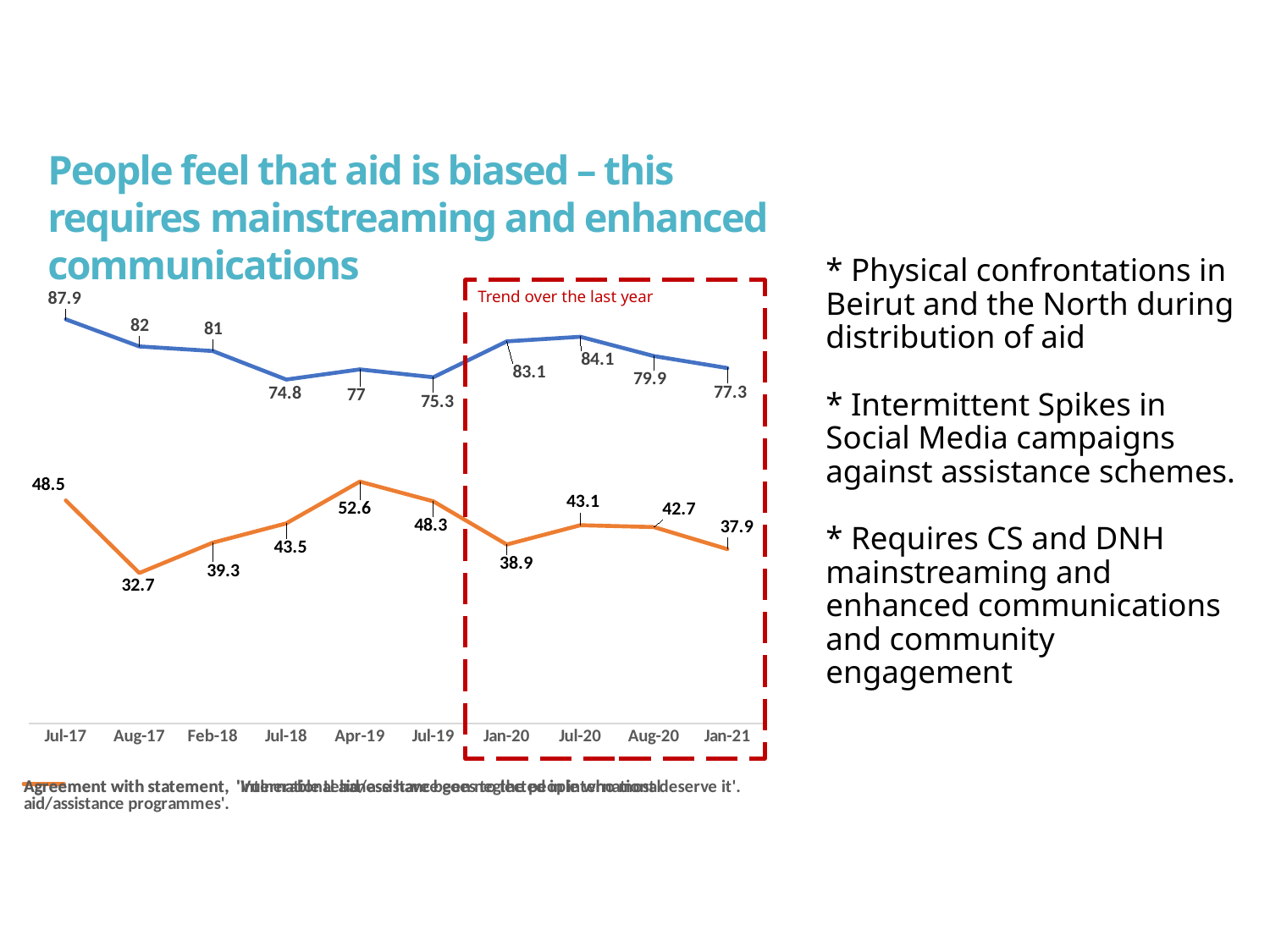
Which is larger for the orange line: the value at Jul-20 or the value at Jan-21? Jul-20 At which time point does the blue line reach its lowest value? Jul-18 What is the value of the orange line at Aug-17? 32.7 Does the orange line rise or fall between Aug-20 and Jan-21? fall What is the value of the orange line at Apr-19? 52.6 What is the value of the blue line at Jan-21? 77.3 How many time points are plotted along the x axis of the chart? 10 What is the difference between the blue line's value at Jul-17 and its value at Jan-21? 10.6 What label is written inside the red dashed box on the chart? Trend over the last year What is the value of the blue line at Jul-17? 87.9 What type of chart is shown on the slide? line chart At which time point does the orange line reach its highest value? Apr-19